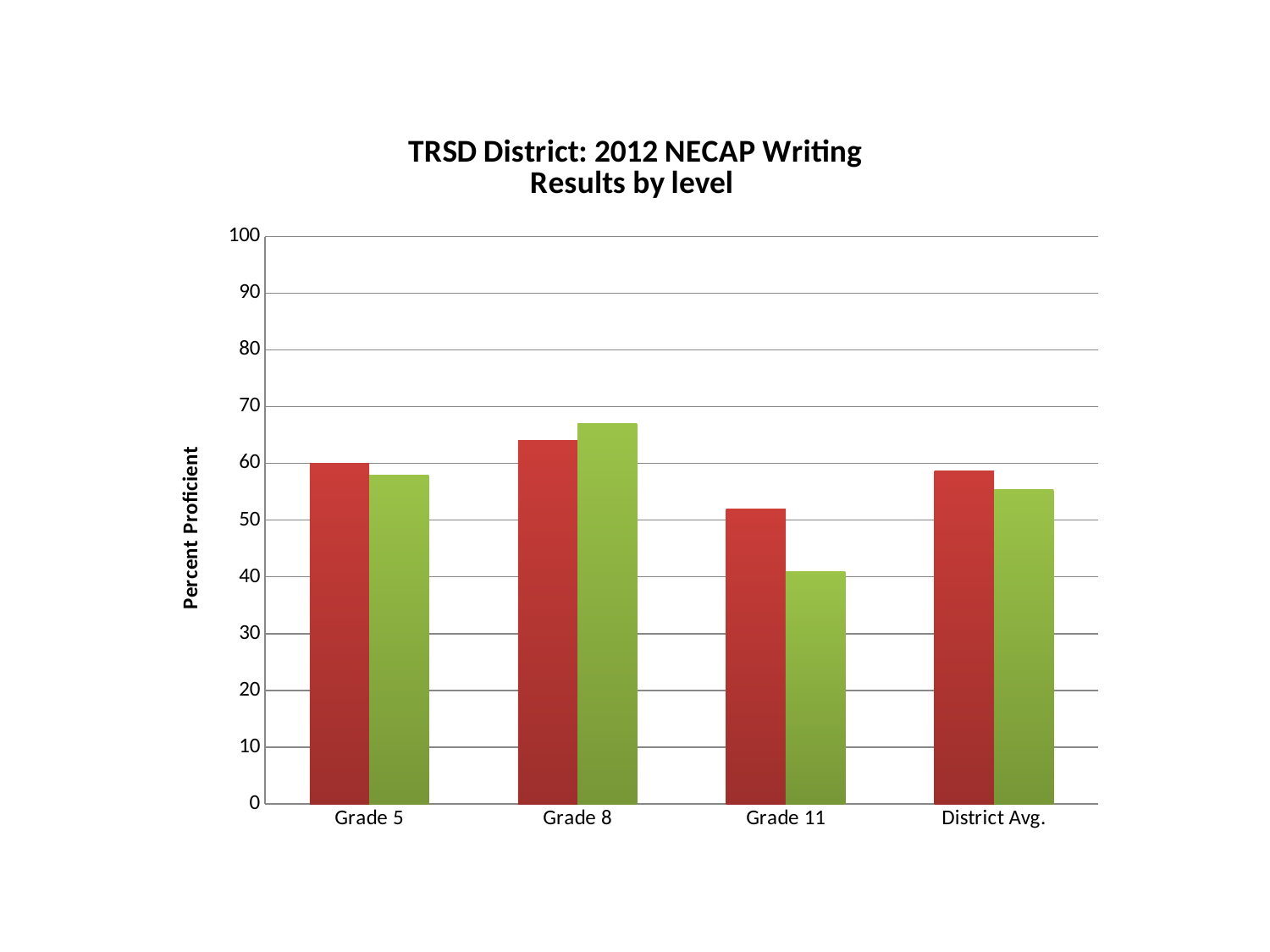
For Grade 8, which bar is taller, the red bar or the green bar? green What is the label on the vertical axis? Percent Proficient Is the value of the green bar for Grade 8 greater or less than 60? greater Which category has the tallest bar overall? Grade 8 Is the value of the red bar for District Avg. greater or less than 50? greater Which category has the tallest red bar? Grade 8 For Grade 11, which bar is taller, the red bar or the green bar? red What is the title of the chart? TRSD District: 2012 NECAP Writing Results by level Is the value of the green bar for Grade 11 greater or less than 50? less What kind of chart is shown on the slide? bar chart How many categories are shown on the x axis? 4 Which category has the shortest green bar? Grade 11